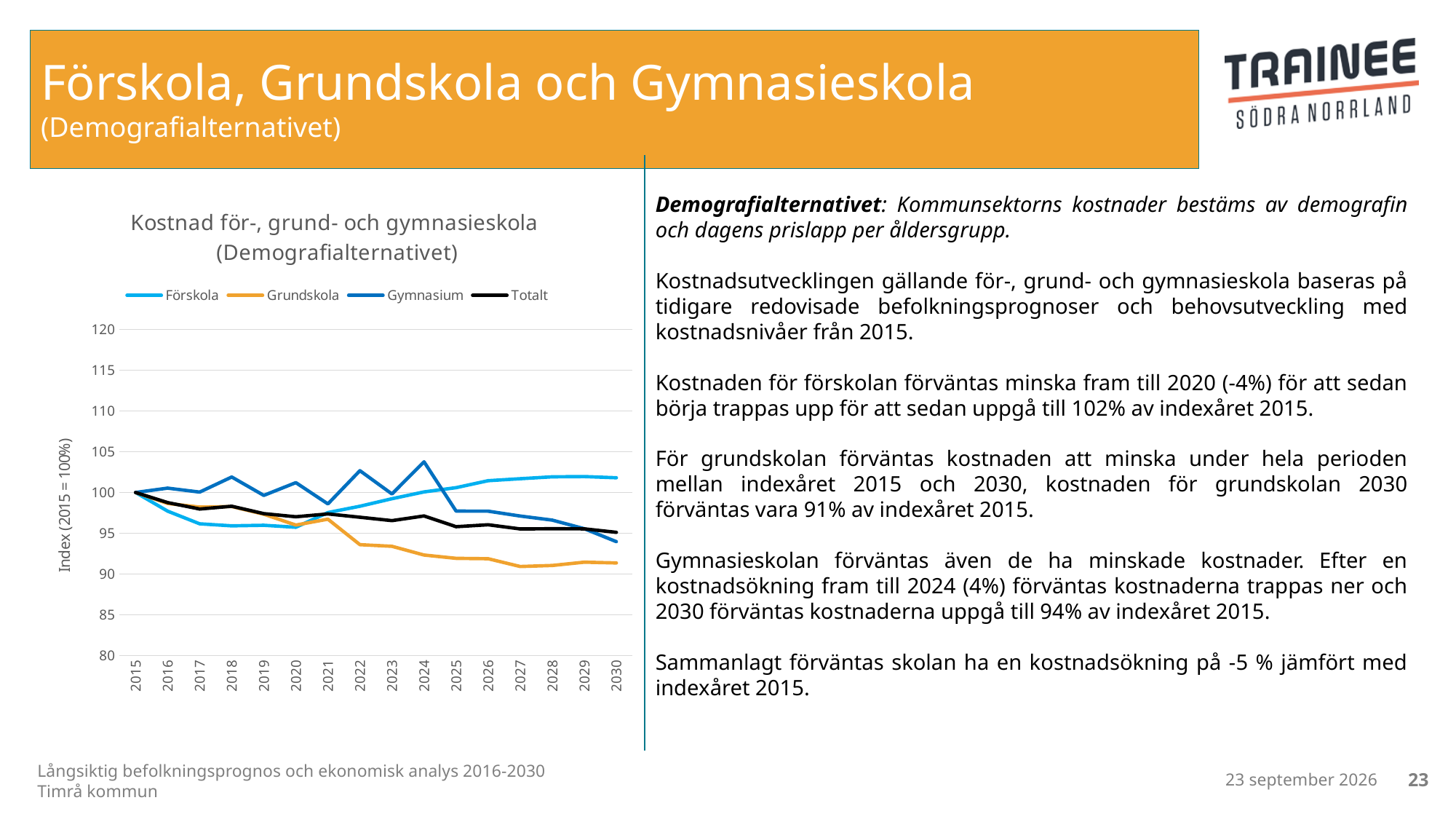
What is the index value for Grundskola in 2015? 100 Which series has the lowest value in 2030? Grundskola Is the value for Förskola in 2030 greater or less than 100? greater Is the value for Grundskola in 2030 greater or less than 95? less Which series has the highest value in 2030? Förskola Is the value for Gymnasium in 2024 greater or less than 100? greater What is the label on the vertical axis of the chart? Index (2015 = 100%) How many series does the chart legend list? 4 What kind of chart is shown on the slide? line chart Does the Grundskola series rise or fall from 2015 to 2030? fall In 2030, which is larger: the value for Förskola or the value for Grundskola? Förskola How many years are plotted along the x axis of the chart? 16